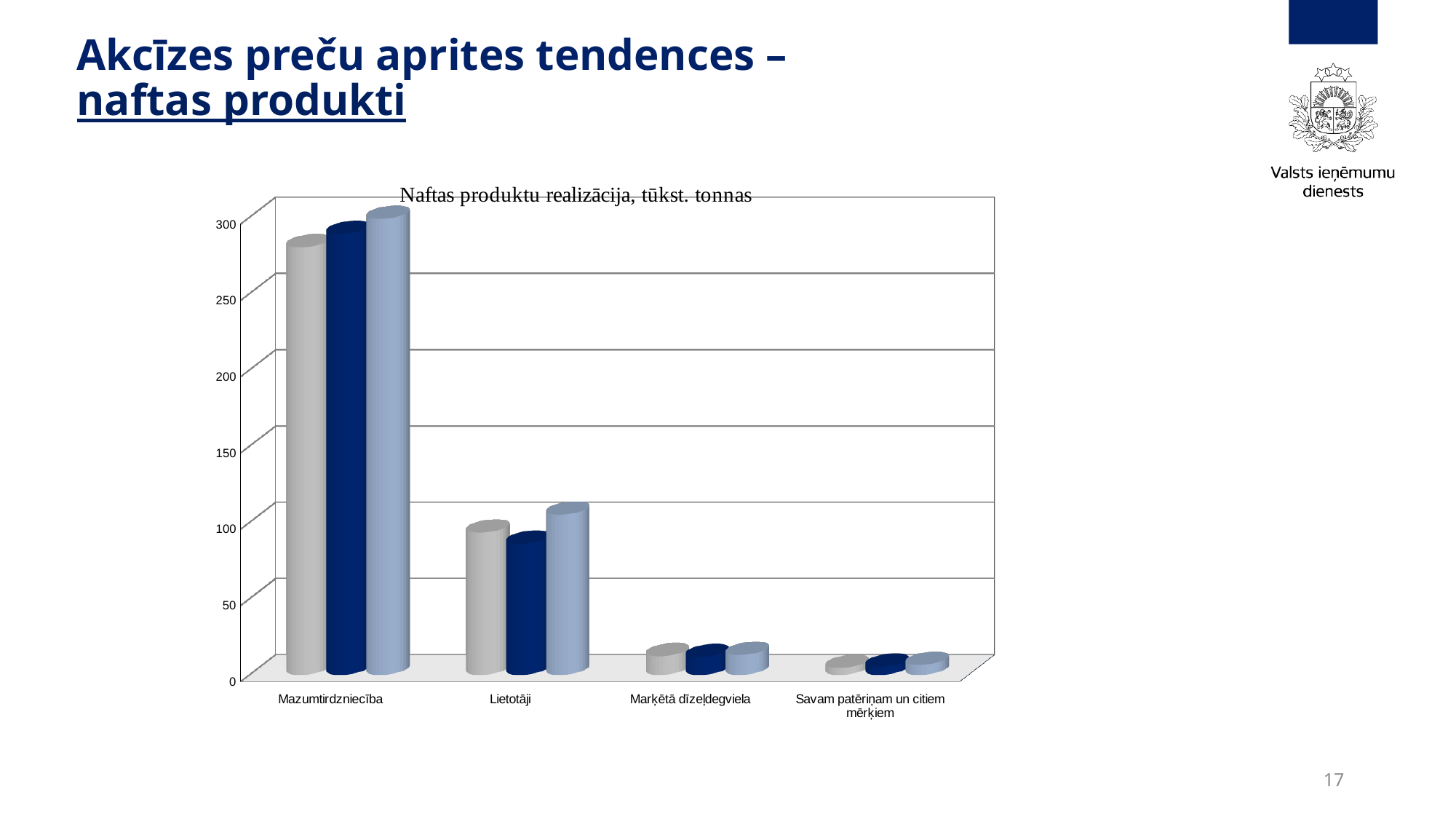
Are the values for Marķētā dīzeļdegviela greater or less than 50? less What is the highest value labelled on the vertical axis of the chart? 300 Which category has the lowest values in the chart? Savam patēriņam un citiem mērķiem What kind of chart is shown on the slide? bar chart Which category has larger values, Lietotāji or Marķētā dīzeļdegviela? Lietotāji Are the values for Mazumtirdzniecība greater or less than 250? greater Do the values rise or fall moving from left to right across the categories? fall What is the title of the chart? Naftas produktu realizācija, tūkst. tonnas Which category has the highest values in the chart? Mazumtirdzniecība Are the values for Lietotāji greater or less than 50? greater How many categories are shown on the x axis of the chart? 4